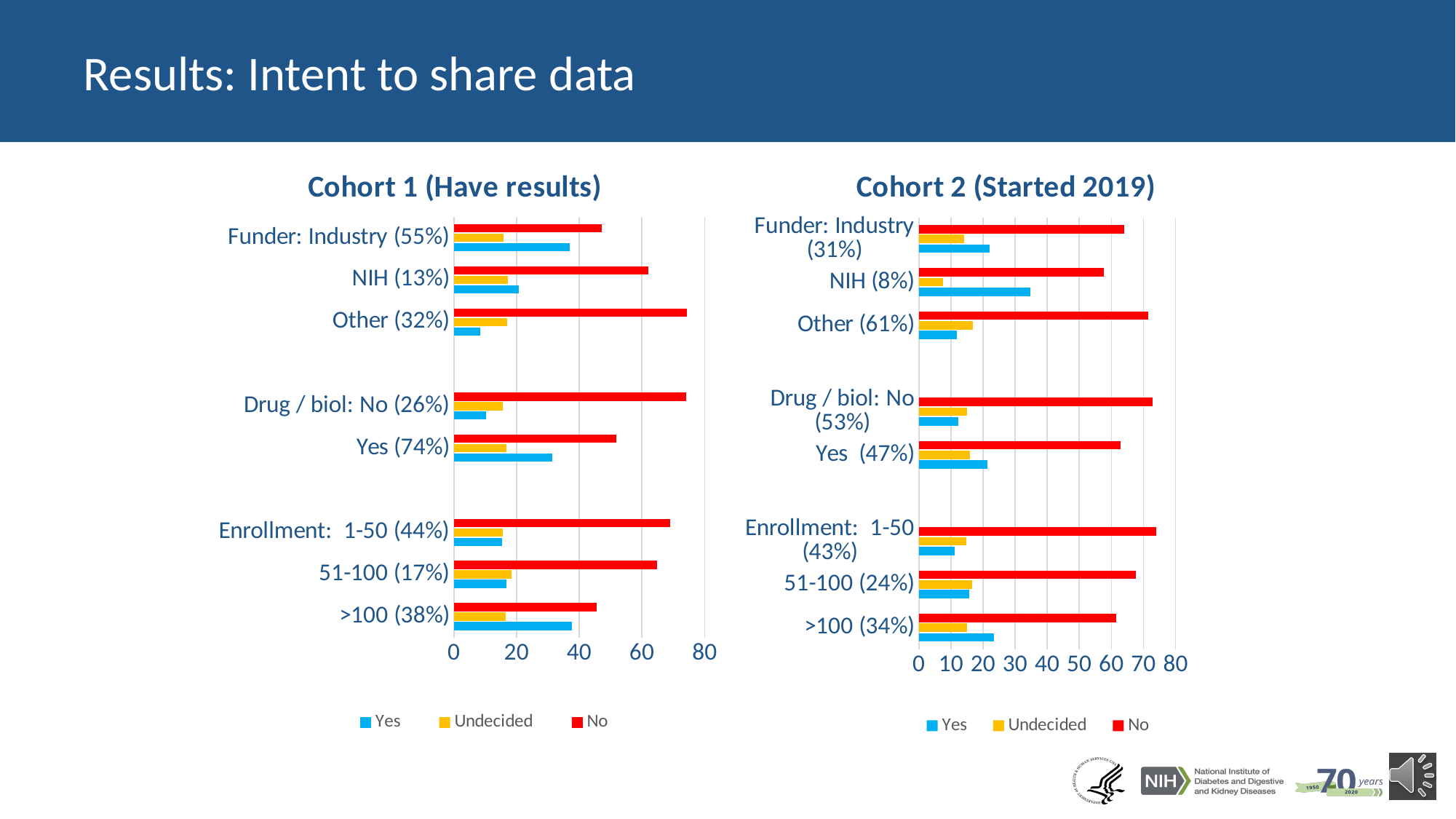
How many series does the legend of the Cohort 2 (Started 2019) chart list? 3 In the Cohort 1 (Have results) chart, is the Yes value for Other (32%) greater or less than 20? less In the Cohort 2 (Started 2019) chart, is the Undecided value for NIH (8%) greater or less than 10? less Which colour represents the No series in the Cohort 2 (Started 2019) chart? red In the Cohort 2 (Started 2019) chart, which category has the highest Yes value? NIH (8%) What kind of chart is the Cohort 1 (Have results) chart? bar chart In the Cohort 2 (Started 2019) chart, is the No value for NIH (8%) greater or less than 50? greater In the Cohort 1 (Have results) chart, which is larger: the No value for Other (32%) or the No value for Funder: Industry (55%)? Other (32%) In the Cohort 1 (Have results) chart, which is larger: the Yes value for Funder: Industry (55%) or the Yes value for NIH (13%)? Funder: Industry (55%) How many categories are plotted on the Cohort 1 (Have results) chart? 8 In the Cohort 1 (Have results) chart, which category has the lowest Yes value? Other (32%)